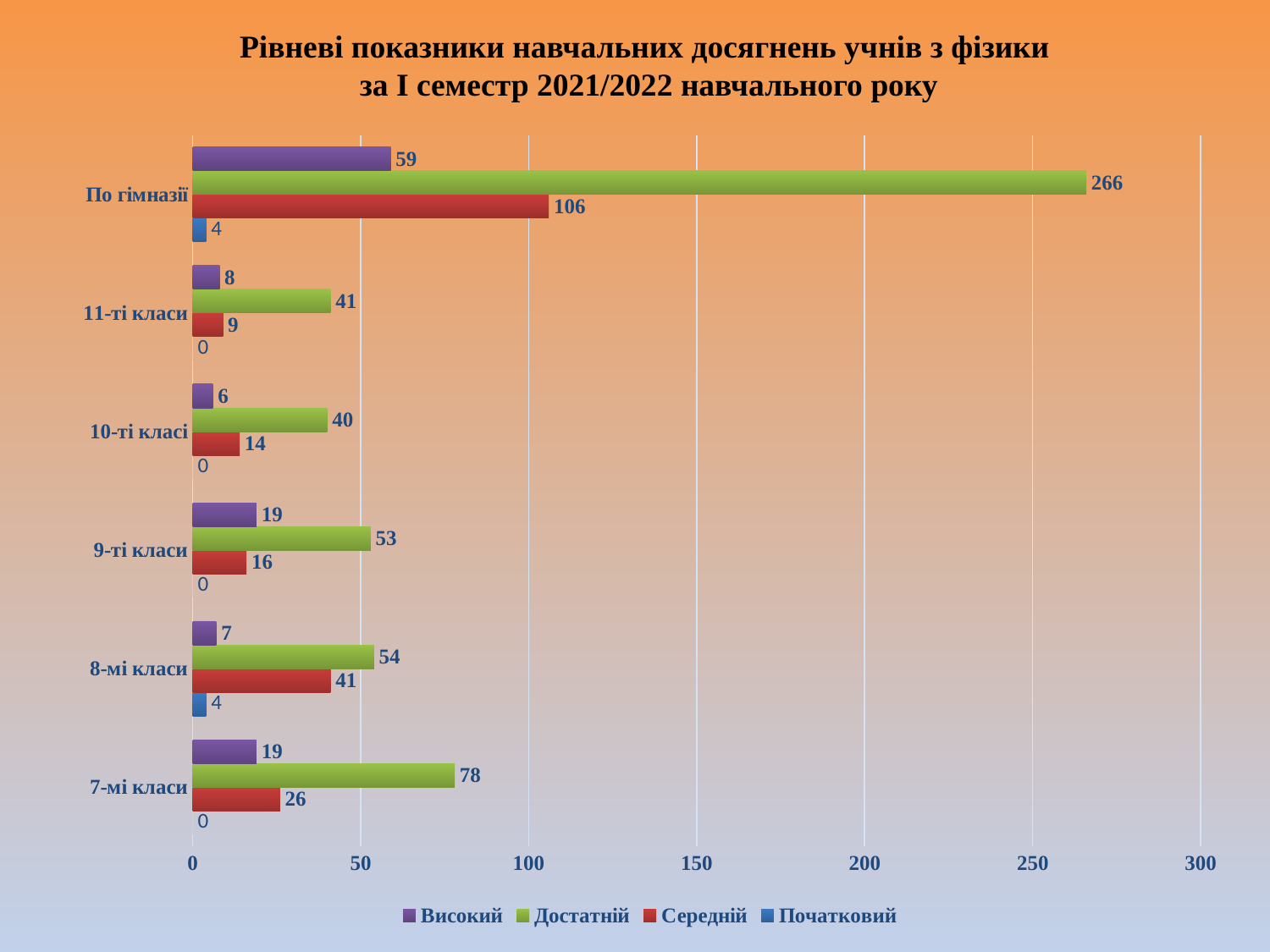
Which is larger: the Середній value for 9-ті класи or the Середній value for 10-ті класі? 9-ті класи How many categories are shown on the vertical axis? 6 What is the value for Середній for 8-мі класи? 41 What is the value for Початковий for 10-ті класі? 0 What is the value for Достатній for По гімназії? 266 How many series does the legend list? 4 What kind of chart is shown on the slide? bar chart Is the Середній value for По гімназії greater or less than 100? greater What is the difference between the Достатній and Середній values for По гімназії? 160 What is the value for Високий for 7-мі класи? 19 Which class category has the highest Достатній value, excluding По гімназії? 7-мі класи Which category has the lowest Високий value? 10-ті класі